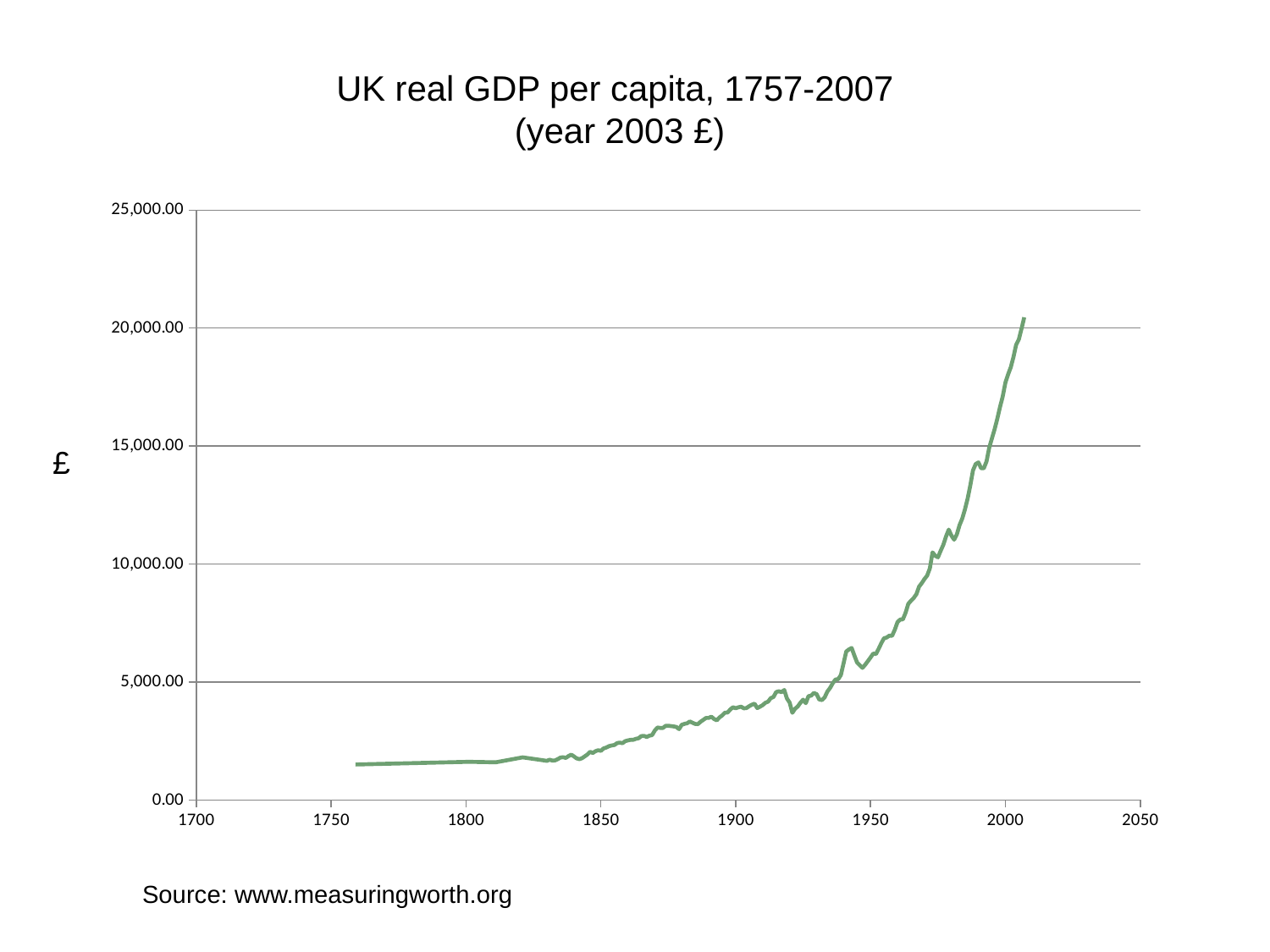
Is the value for 1800 greater or less than 5,000.00? less Is the value for 1950 greater or less than 10,000.00? less Is the value for 2000 greater or less than 15,000.00? greater What is the source cited below the chart? www.measuringworth.org What is the title of the chart? UK real GDP per capita, 1757-2007 (year 2003 £) Does UK real GDP per capita rise or fall overall from 1757 to 2007? rise Which is larger, the value for 1850 or the value for 1950? 1950 What kind of chart is shown on the slide? line chart In which year does the line reach its highest value? 2007